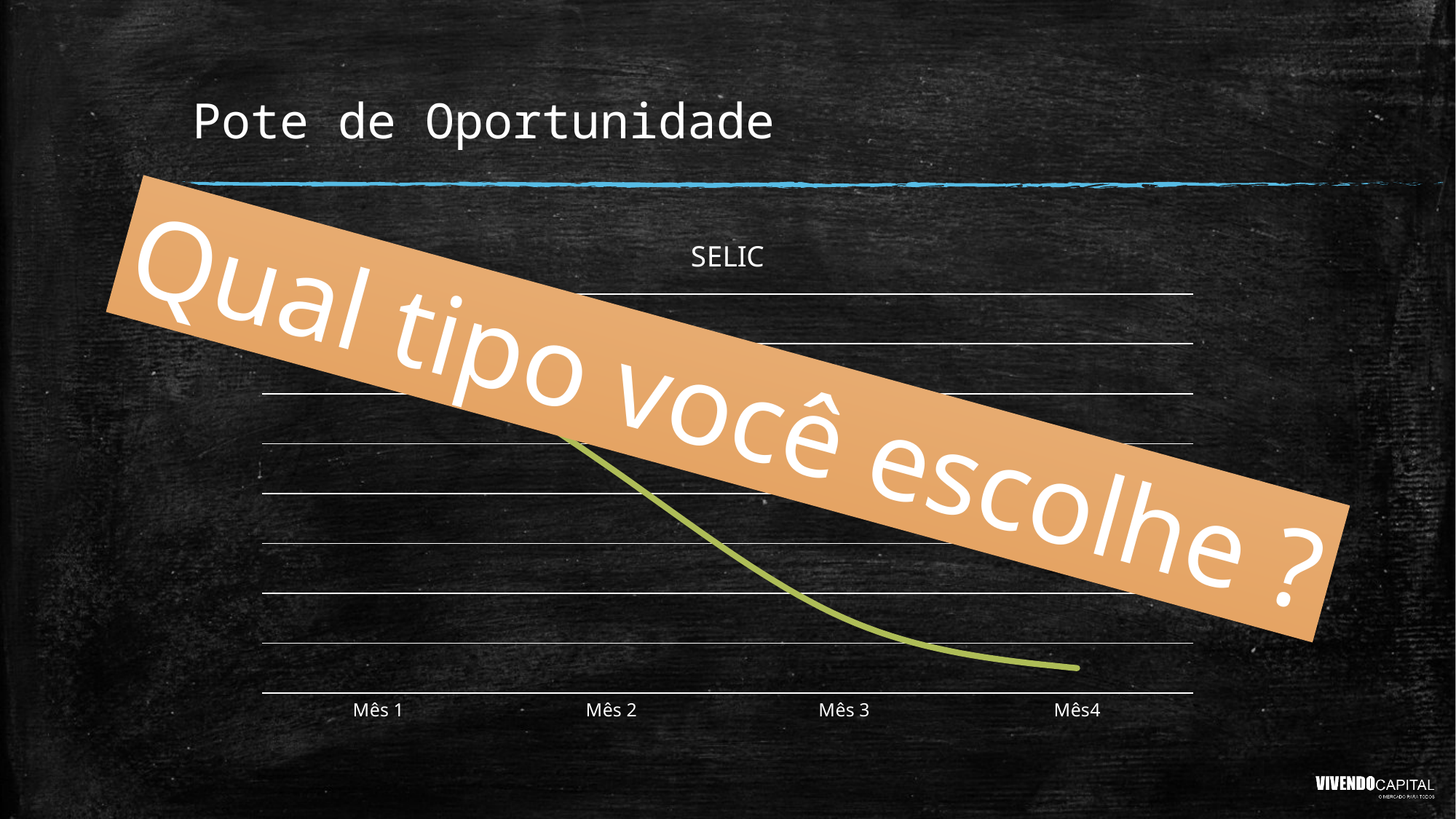
Which is larger in the SELIC chart, the value at Mês 2 or the value at Mês4? Mês 2 What is the label of the last category on the x axis of the SELIC chart? Mês4 Which is larger in the SELIC chart, the value at Mês 2 or the value at Mês 3? Mês 2 Does the SELIC line rise or fall from Mês 2 to Mês4? Falls How many categories are shown on the x axis of the SELIC chart? 4 What kind of chart is shown on the slide? Line chart What is the title of the chart? SELIC Which is larger in the SELIC chart, the value at Mês 3 or the value at Mês4? Mês 3